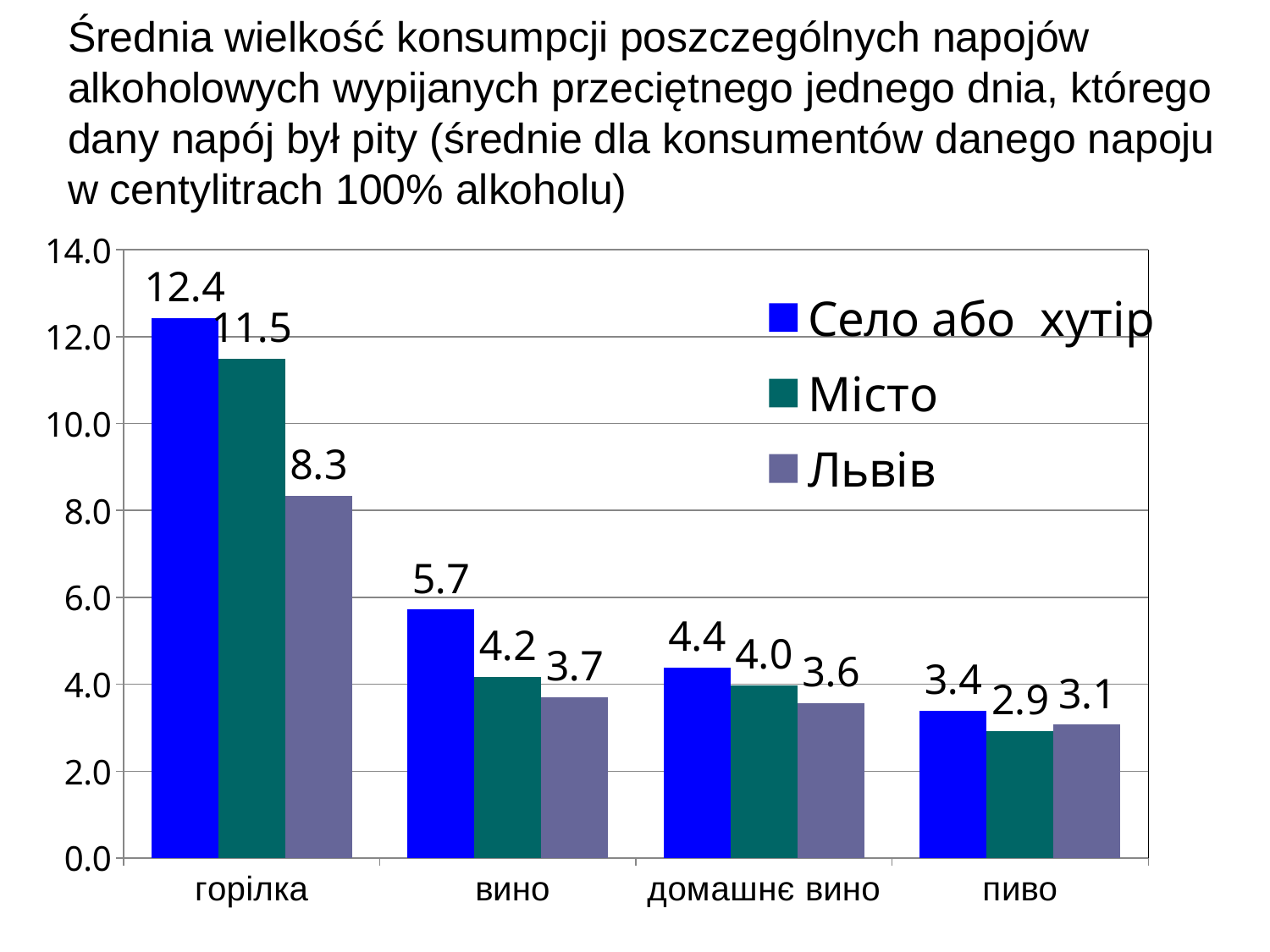
Do the Село або хутір values rise or fall from горілка to пиво? fall What is the difference between the Село або хутір and Львів values for горілка? 4.1 What kind of chart is shown? bar chart What is the value for Місто for пиво? 2.9 Which series is shown in blue in the legend? Село або хутір Which category has the lowest value for Село або хутір? пиво How many categories are shown on the x axis? 4 What is the value for Львів for вино? 3.7 Which is larger for домашнє вино: Місто or Львів? Місто How many series does the legend list? 3 Which category has the highest value for Місто? горілка What is the value for Село або хутір for горілка? 12.4